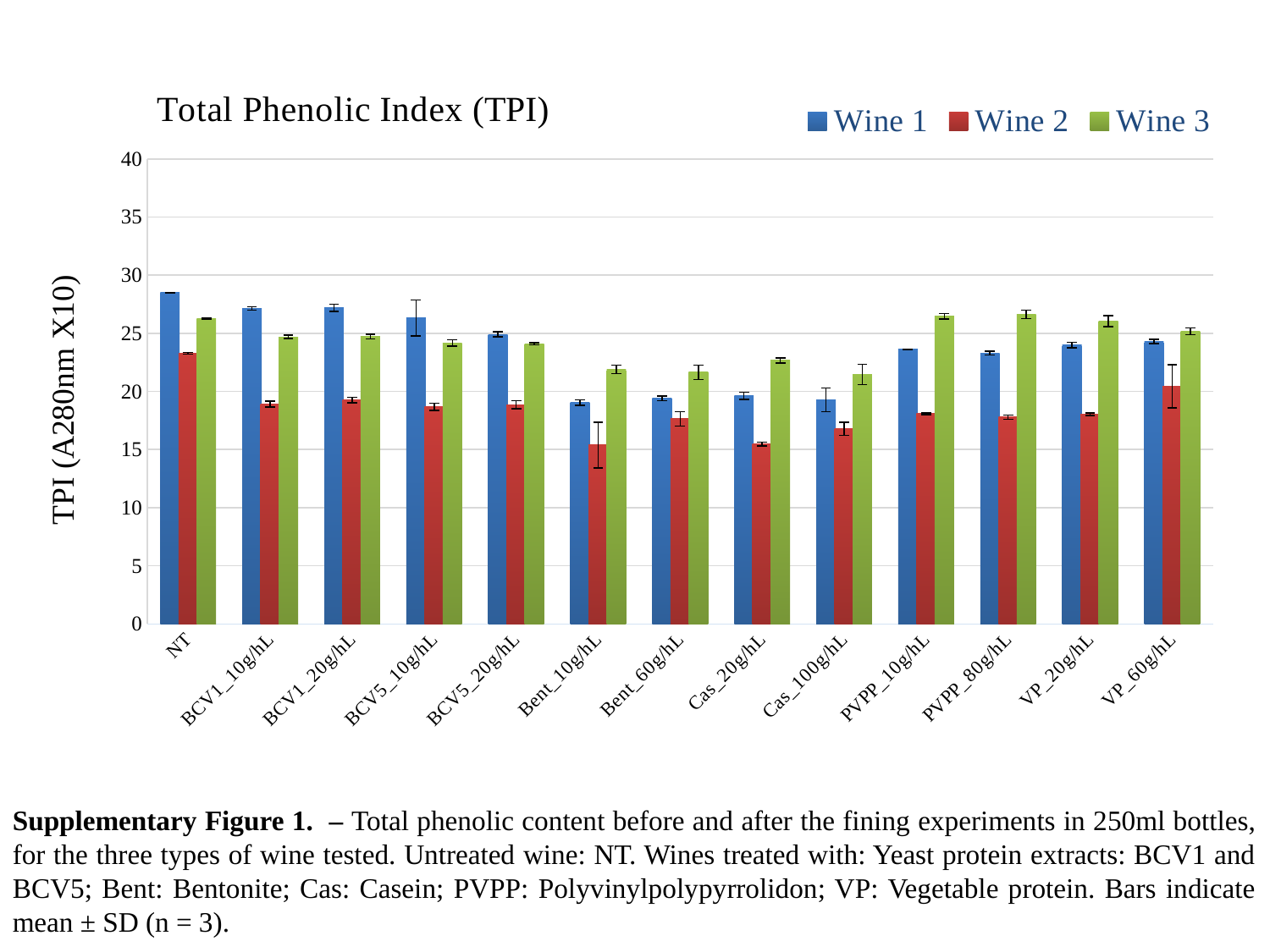
What is the title of the chart? Total Phenolic Index (TPI) How many treatment categories are shown on the x axis? 13 What is the label on the y axis? TPI (A280nm X10) For PVPP_10g/hL, which is larger: the Wine 1 value or the Wine 3 value? Wine 3 How many series does the legend list? 3 For NT, which is larger: the Wine 1 value or the Wine 2 value? Wine 1 Is the Wine 2 value for NT greater or less than 20? greater Is the Wine 2 value for Bent_10g/hL greater or less than 20? less What kind of chart is shown on the slide? bar chart Is the Wine 3 value for Bent_10g/hL greater or less than 25? less